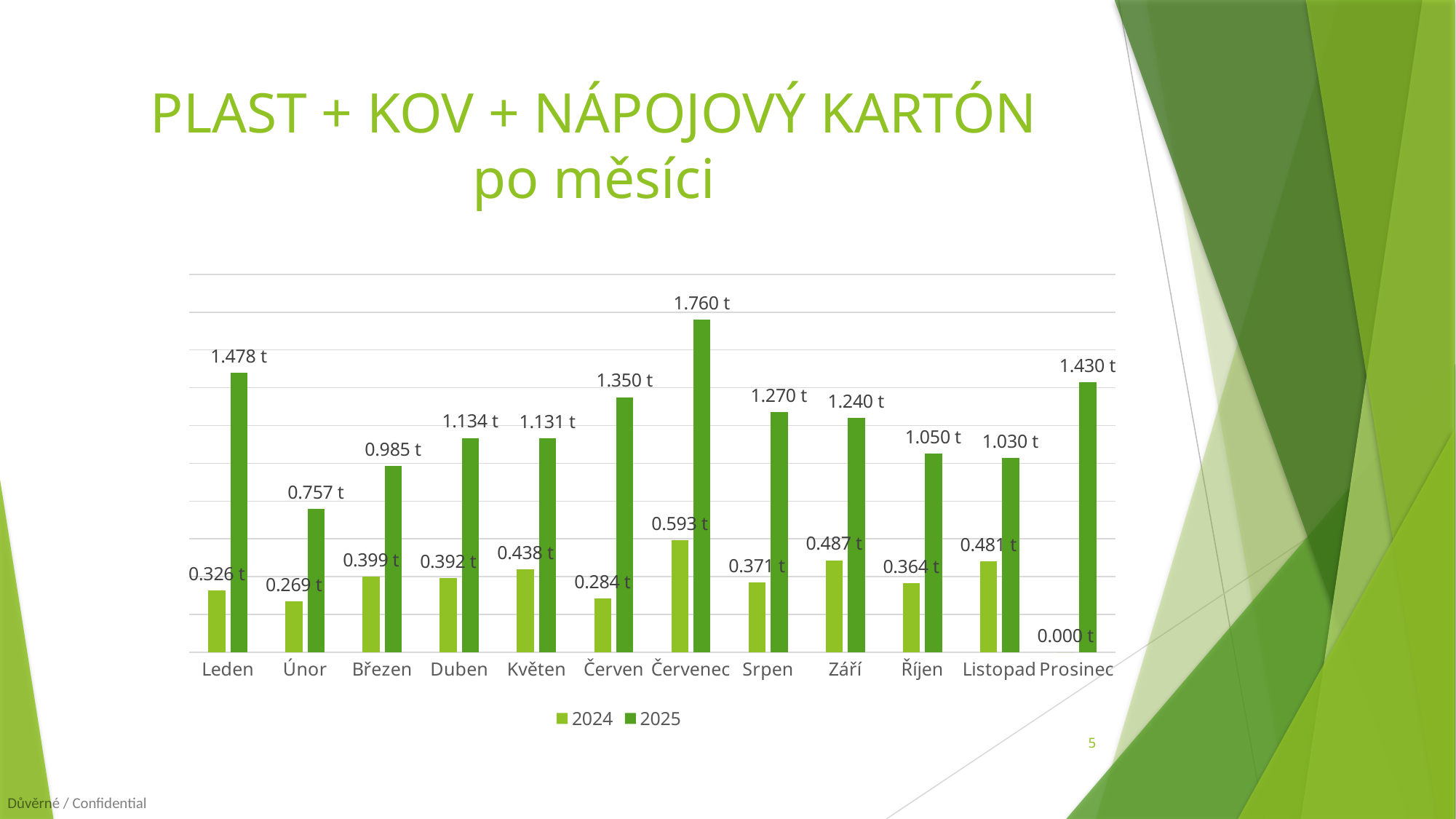
How many series does the legend list? 2 What is the 2025 value for Leden? 1.478 t What is the 2025 value for Červenec? 1.760 t What is the 2024 value for Prosinec? 0.000 t What is the difference between the 2025 and 2024 values for Červenec? 1.167 t What kind of chart is shown on the slide? Bar chart Which month has the lowest 2024 value? Prosinec Which month has the highest 2025 value? Červenec Which month has the highest 2024 value? Červenec How many months are shown on the x axis? 12 Which is larger, the 2025 value for Duben or the 2025 value for Únor? Duben What is the 2024 value for Květen? 0.438 t